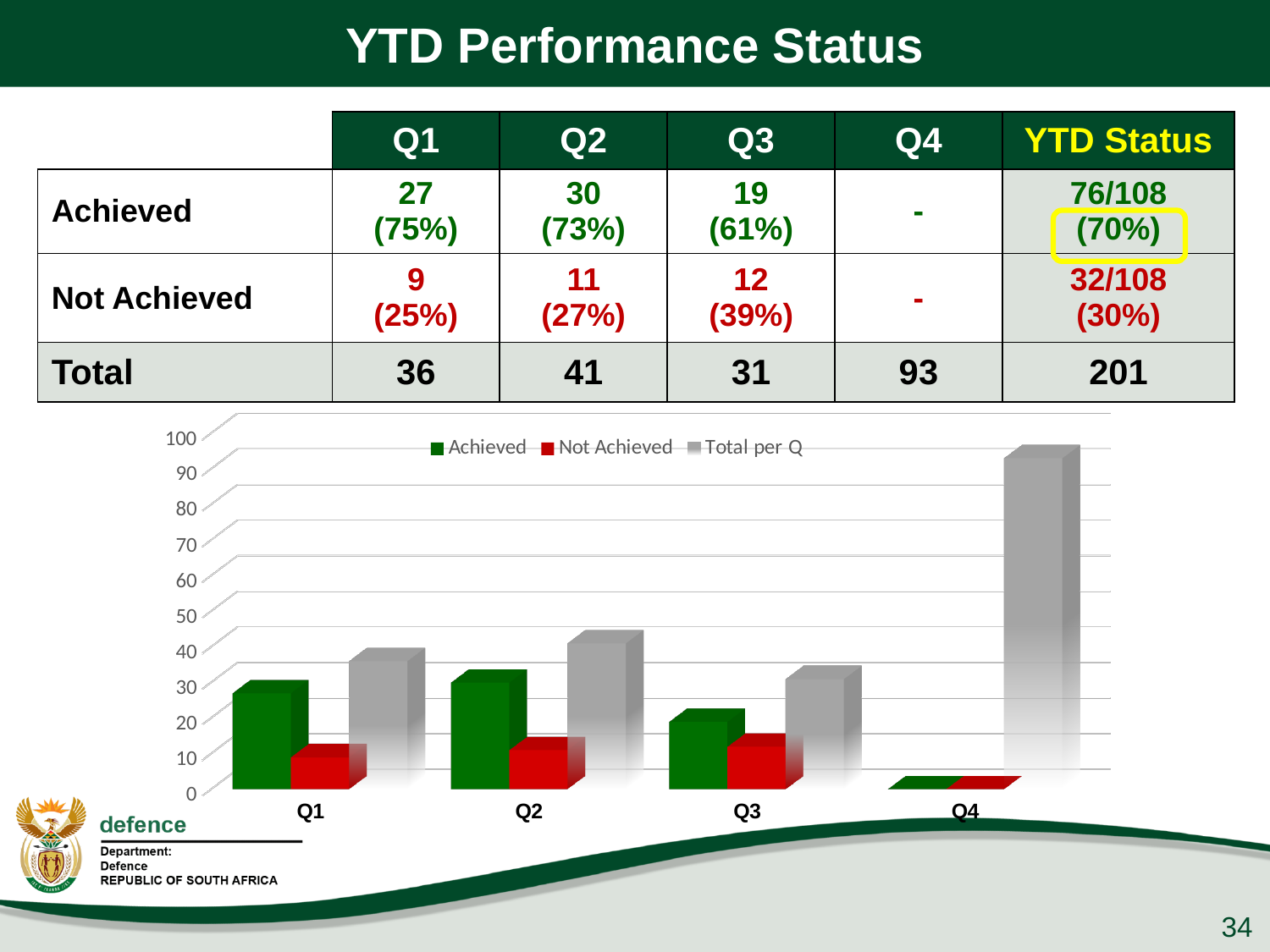
Is the Total per Q value for Q4 greater or less than 80? greater What is the difference between the Achieved and Not Achieved values for Q1? 18 What kind of chart is shown on the slide? bar chart Which series in the legend is shown in red? Not Achieved Which quarter has the lowest Achieved bar? Q4 How many series does the chart legend list? 3 What is the Achieved value for Q2? 30 Is the Achieved bar for Q1 or for Q3 taller? Q1 What is the Total per Q value for Q4? 93 What is the Not Achieved value for Q3? 12 How many quarters are shown on the x axis of the chart? 4 Which quarter has the highest Total per Q bar? Q4